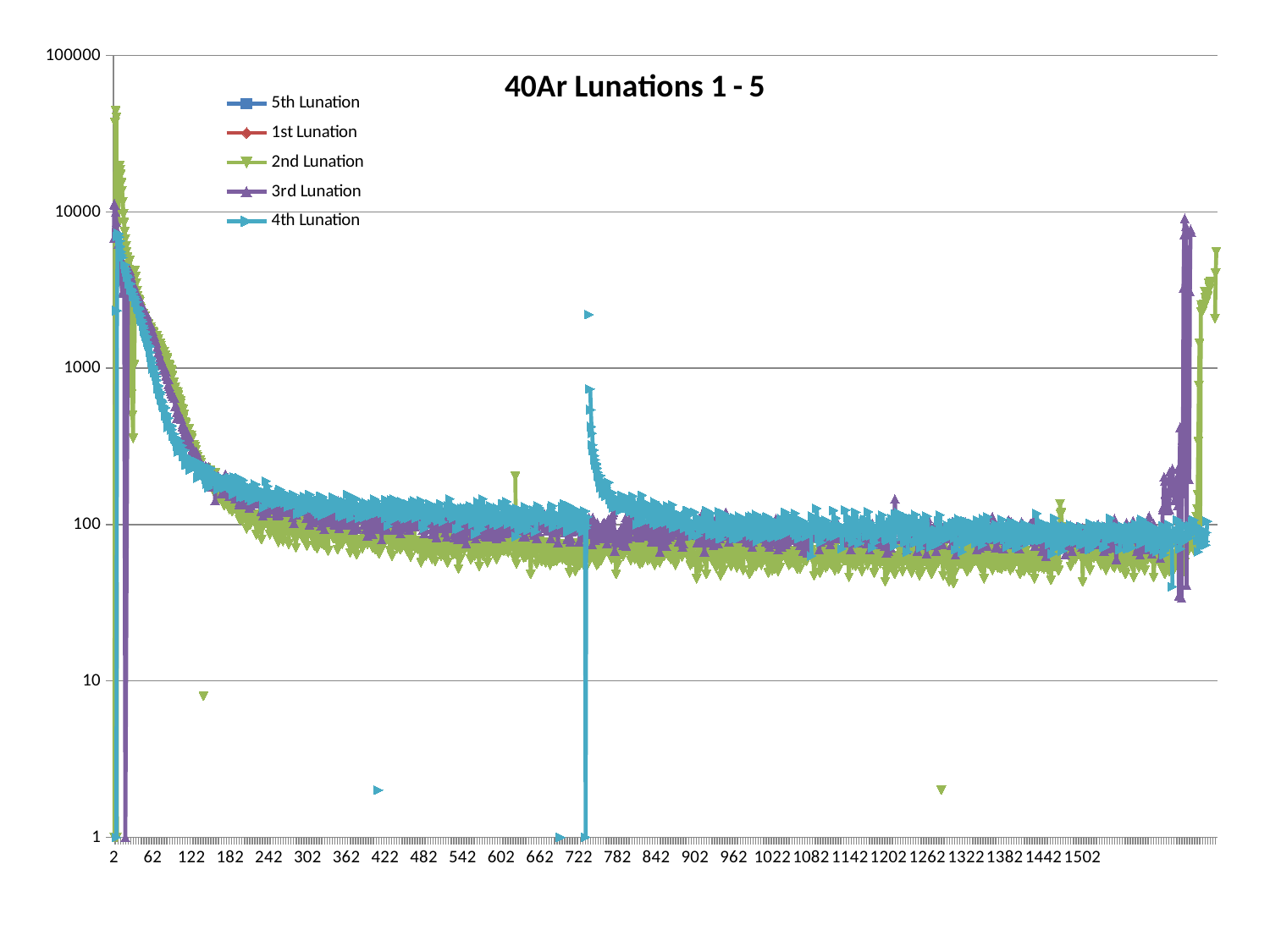
Is the value for the 4th Lunation at x = 902 greater or less than 1000? less Around x = 902, which series has the larger value, the 4th Lunation or the 2nd Lunation? 4th Lunation Is the value for the 2nd Lunation at x = 902 greater or less than 10? greater What kind of chart is shown on the slide? line chart Do the values for the 4th Lunation rise or fall along the x axis between 2 and 182? fall How many series does the legend list? 5 Which series is plotted in green with downward-pointing triangle markers? 2nd Lunation What is the title of the chart? 40Ar Lunations 1 - 5